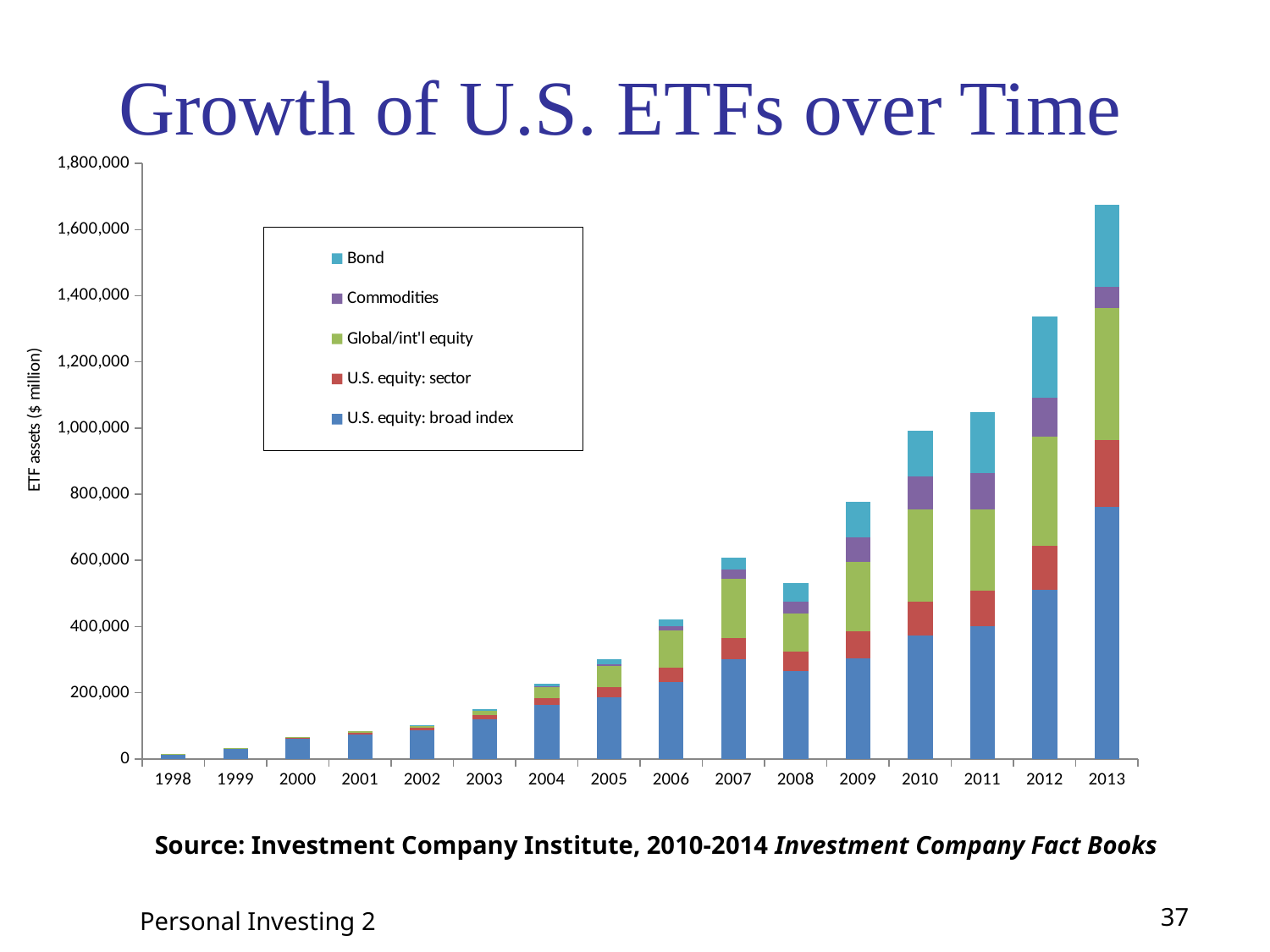
Do total ETF assets generally rise or fall from 1998 to 2013? Rise How many years are shown along the x axis of the chart? 16 What is the label on the chart's vertical axis? ETF assets ($ million) Is the total ETF assets value for 2012 greater or less than 1,200,000? greater How many series does the chart's legend list? 5 Which year has the lowest total ETF assets? 1998 Which year has the highest total ETF assets? 2013 Which year has larger total ETF assets, 2007 or 2008? 2007 What kind of chart is shown on the slide? Stacked bar chart Is the total ETF assets value for 2008 greater or less than 600,000? less Is the total ETF assets value for 2003 greater or less than 200,000? less